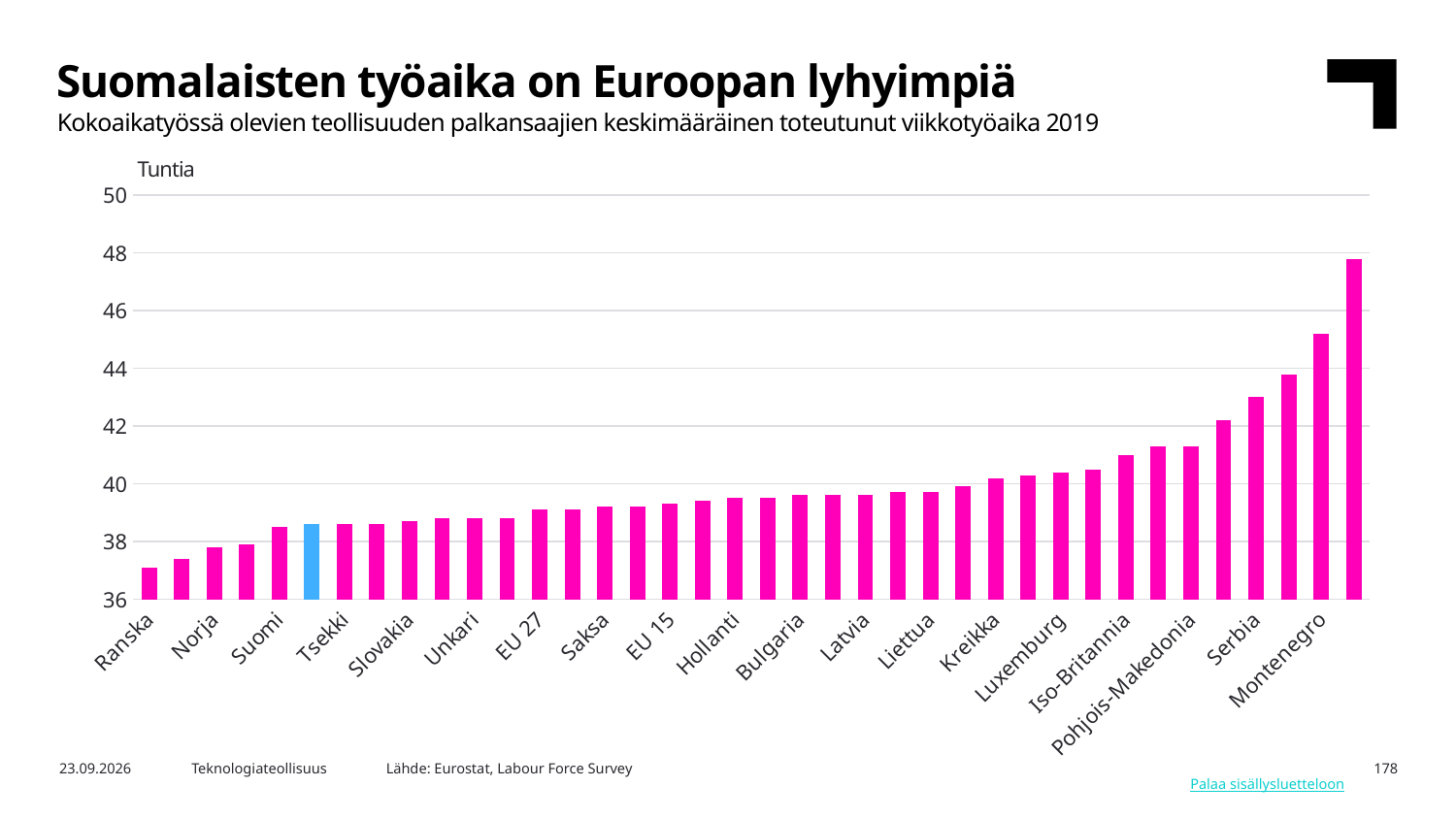
Which has a higher value, Montenegro or Ranska? Montenegro Which country has the lowest average weekly working time in the chart? Ranska Is the value for Iso-Britannia greater or less than 40? greater What kind of chart is shown on the slide? bar chart Do the values rise or fall from left to right along the x axis? rise Is the value for Montenegro greater or less than 44? greater What unit is shown on the vertical axis of the chart? Tuntia Is the value for Ranska greater or less than 38? less Which has a higher value, Serbia or Suomi? Serbia